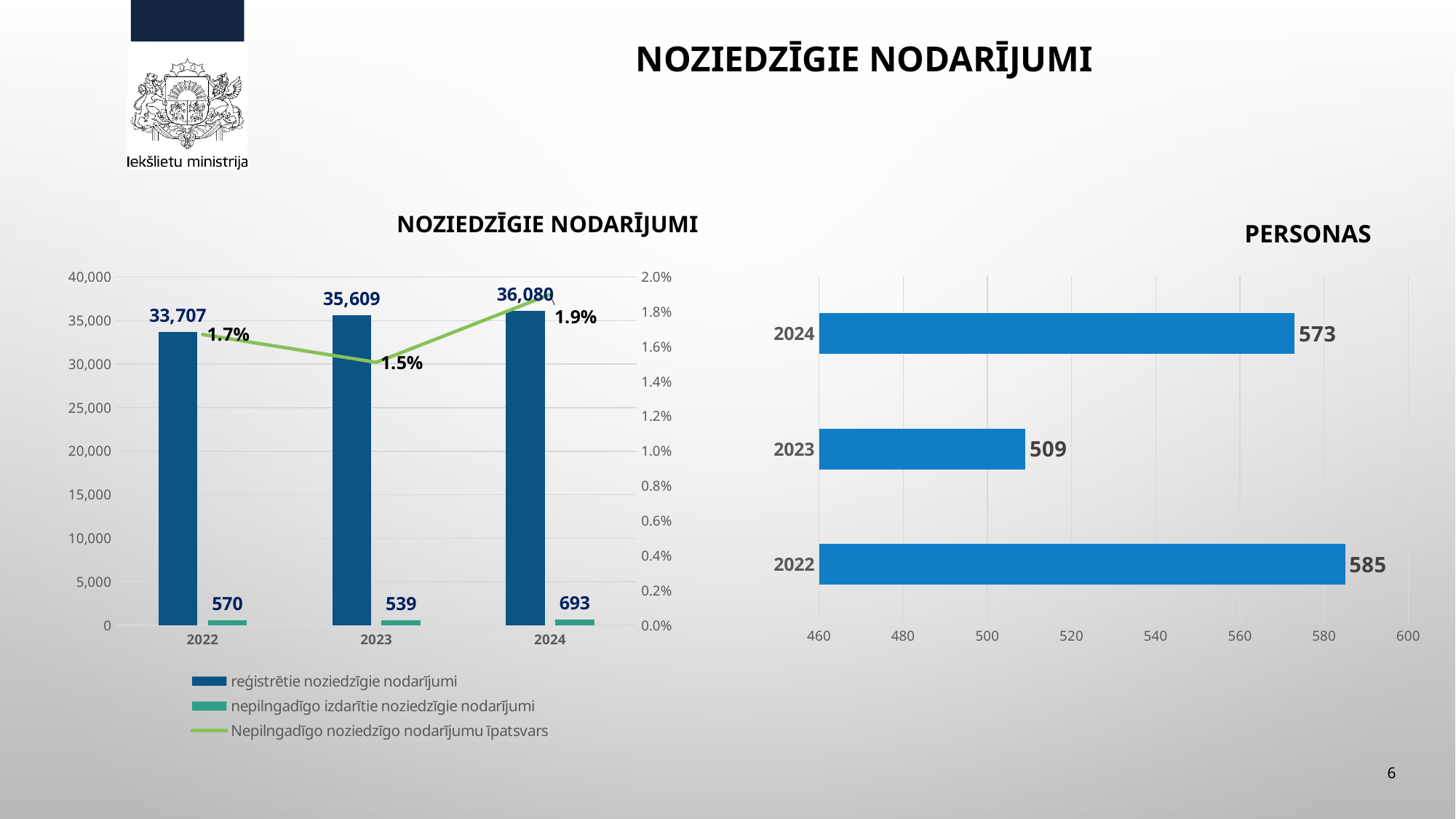
In the NOZIEDZĪGIE NODARĪJUMI chart, what is the value of reģistrētie noziedzīgie nodarījumi for 2023? 35,609 In the PERSONAS chart, which year has the highest value? 2022 In the NOZIEDZĪGIE NODARĪJUMI chart, which year has the lowest value of nepilngadīgo izdarītie noziedzīgie nodarījumi? 2023 In the NOZIEDZĪGIE NODARĪJUMI chart, what is the Nepilngadīgo noziedzīgo nodarījumu īpatsvars for 2023? 1.5% In the NOZIEDZĪGIE NODARĪJUMI chart, do the values of reģistrētie noziedzīgie nodarījumi rise or fall from 2022 to 2024? rise In the NOZIEDZĪGIE NODARĪJUMI chart, what is the value of nepilngadīgo izdarītie noziedzīgie nodarījumi for 2024? 693 In the PERSONAS chart, what is the difference between the values for 2022 and 2024? 12 In the PERSONAS chart, what is the value for 2023? 509 In the NOZIEDZĪGIE NODARĪJUMI chart, which year has the highest value of reģistrētie noziedzīgie nodarījumi? 2024 In the NOZIEDZĪGIE NODARĪJUMI chart, what is the difference between reģistrētie noziedzīgie nodarījumi in 2024 and 2022? 2,373 What kind of chart is the PERSONAS chart? bar chart In the NOZIEDZĪGIE NODARĪJUMI chart, how many series does the legend list? 3